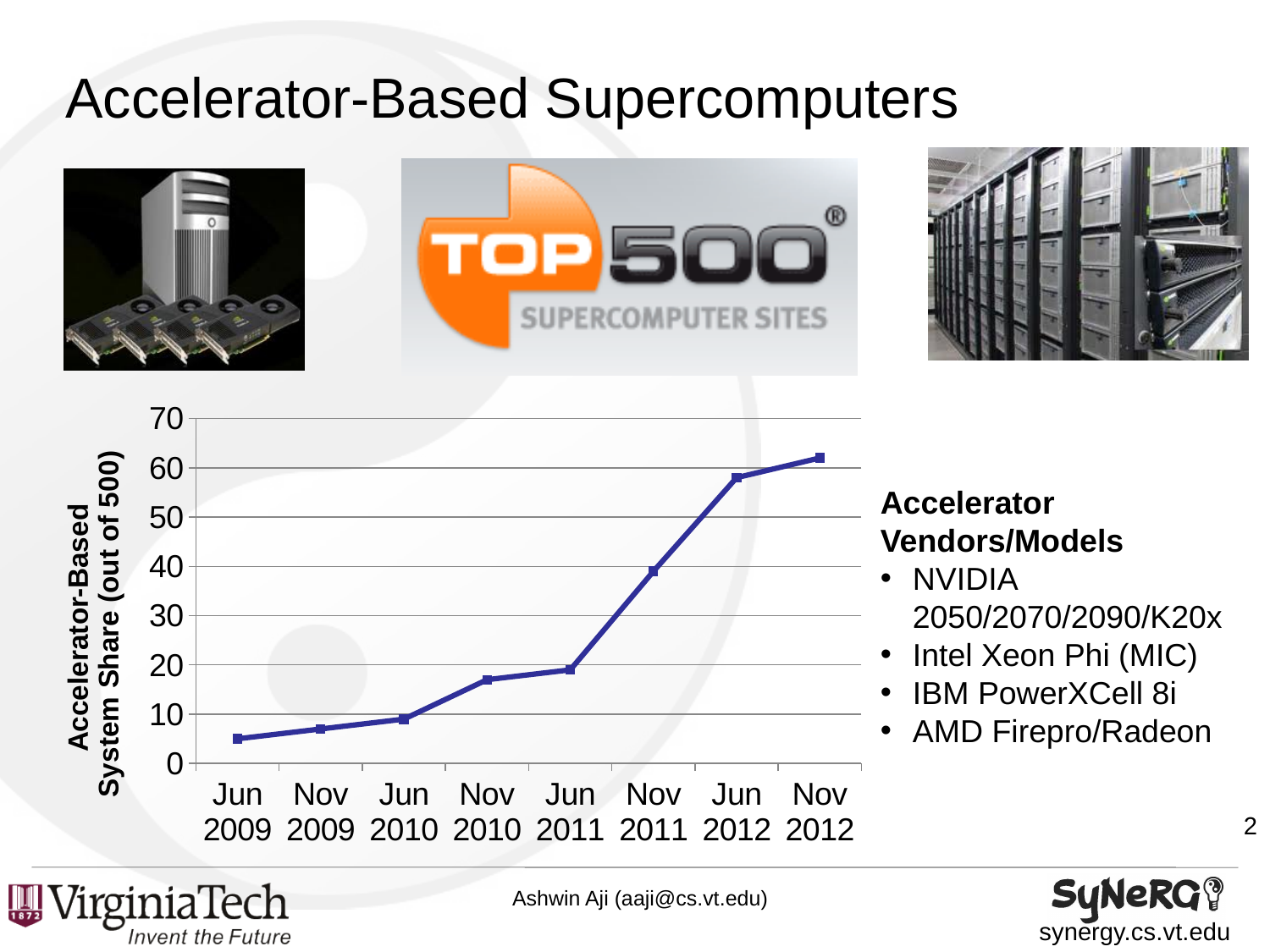
Do the values rise or fall from Jun 2009 to Nov 2012? rise Which is larger, the value for Nov 2009 or the value for Nov 2011? Nov 2011 Which period has the lowest accelerator-based system share? Jun 2009 Which is larger, the value for Jun 2012 or the value for Jun 2011? Jun 2012 What is the label of the vertical axis of the chart? Accelerator-Based System Share (out of 500) Which period has the highest accelerator-based system share? Nov 2012 Is the value for Nov 2012 greater or less than 50? greater Is the value for Nov 2010 greater or less than 10? greater Is the value for Jun 2009 greater or less than 10? less How many data points are plotted on the line chart? 8 What kind of chart is shown on the slide? line chart